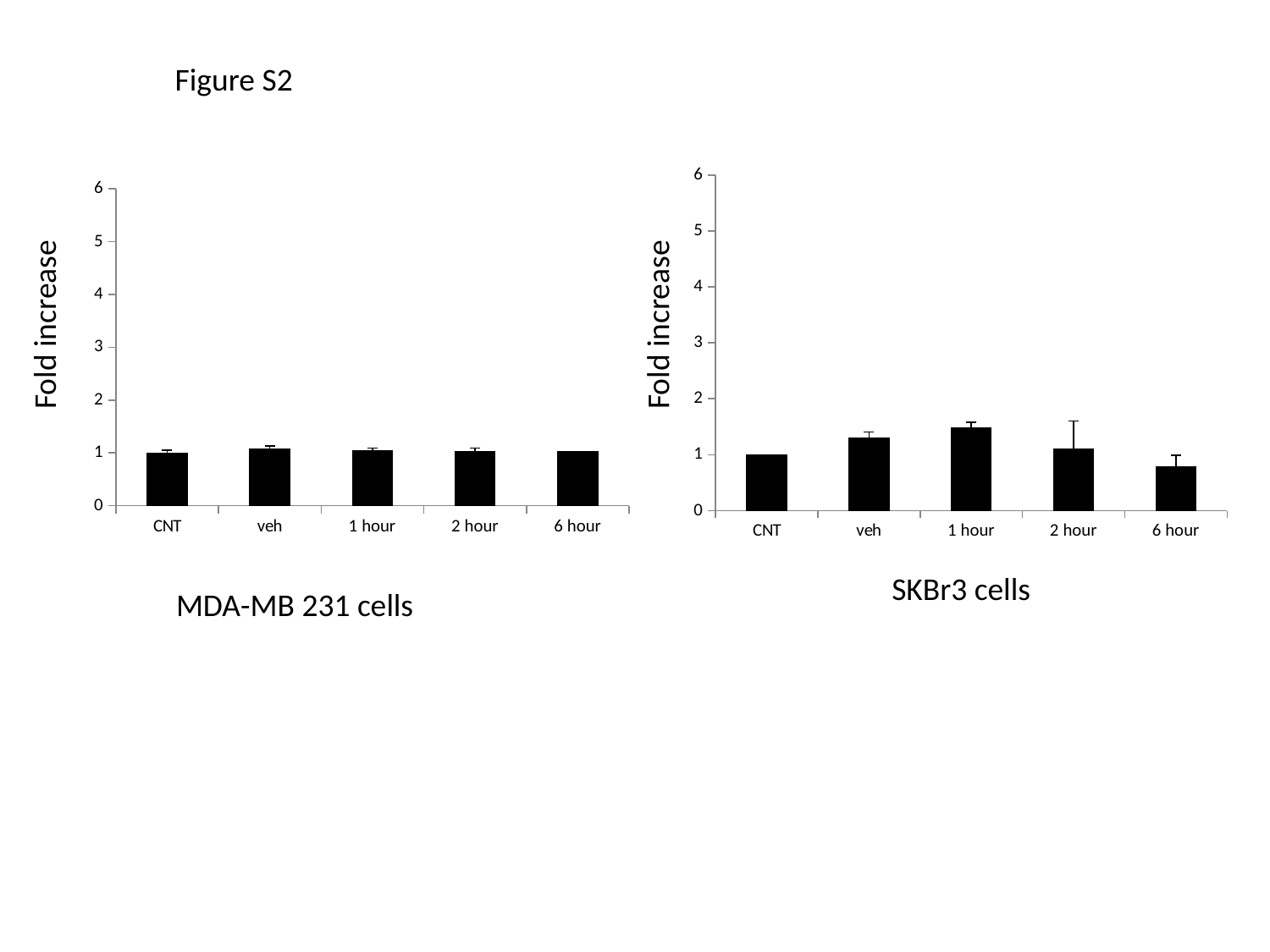
In the SKBr3 cells chart, is the value for 1 hour greater or less than 2? less In the SKBr3 cells chart, which category has the lowest bar? 6 hour How many bar charts are on the slide? 2 What is the maximum value shown on the y-axis of the SKBr3 cells chart? 6 In the SKBr3 cells chart, is the value for veh greater or less than 1? greater In the MDA-MB 231 cells chart, is the value for 2 hour greater or less than 2? less What is the y-axis label of the MDA-MB 231 cells chart? Fold increase How many bars are shown in the SKBr3 cells chart? 5 In the SKBr3 cells chart, is the bar for 1 hour or the bar for 6 hour taller? 1 hour In the SKBr3 cells chart, which category has the highest bar? 1 hour What kind of chart is the MDA-MB 231 cells chart? bar chart